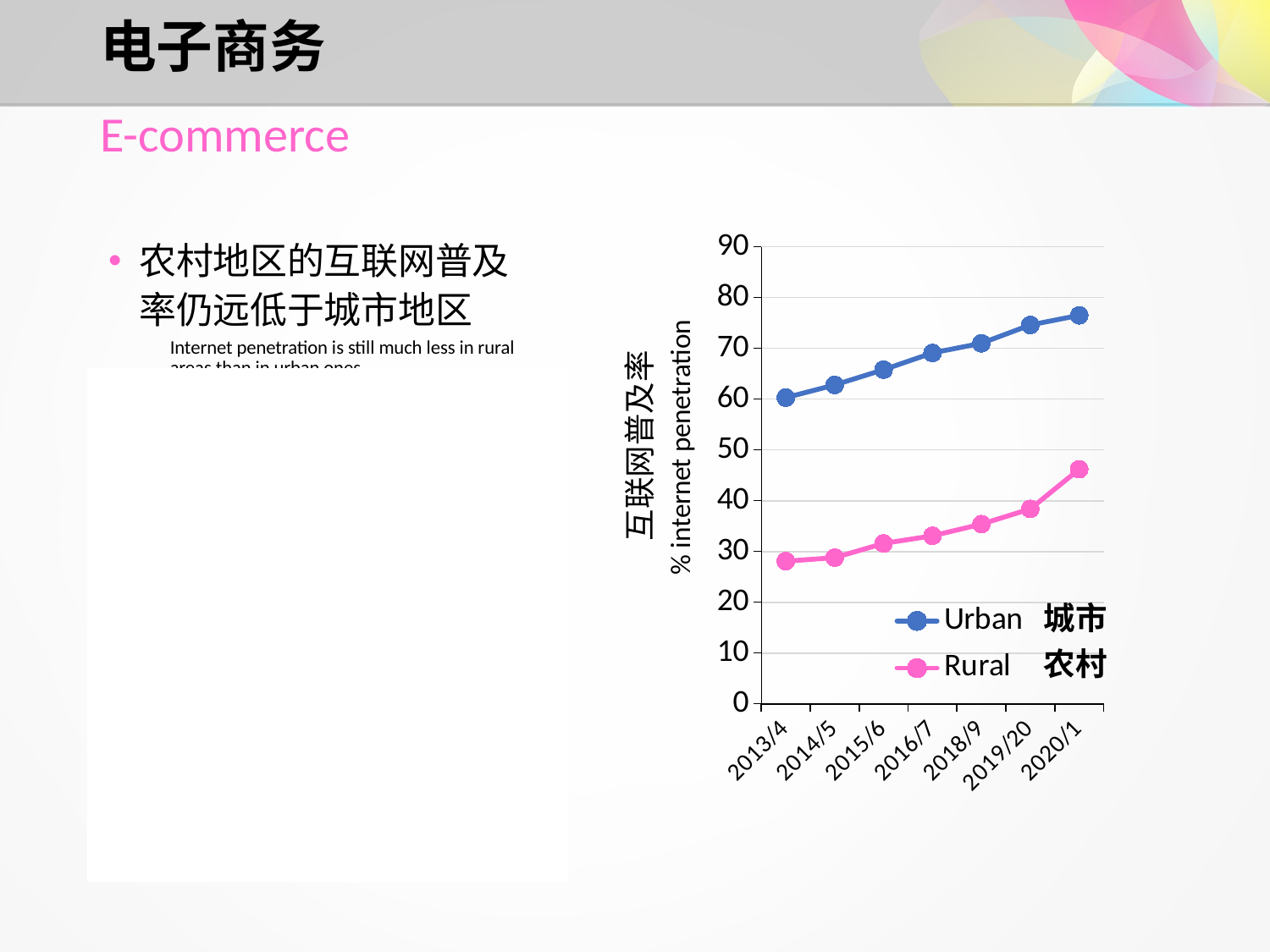
Is the Rural value for 2013/4 greater or less than 30? less Is the Rural value for 2020/1 greater or less than 40? greater Which series is plotted in pink on the chart? Rural Is the Urban value for 2015/6 greater or less than 60? greater How many time points are plotted along the x axis of the chart? 7 Do the Urban values rise or fall from 2013/4 to 2020/1? rise What kind of chart is shown on the slide? line chart In 2020/1, which series has the higher value, Urban or Rural? Urban What is the label on the vertical axis of the chart (in English)? % internet penetration How many series does the chart's legend list? 2 At which time point does the Rural series reach its highest value? 2020/1